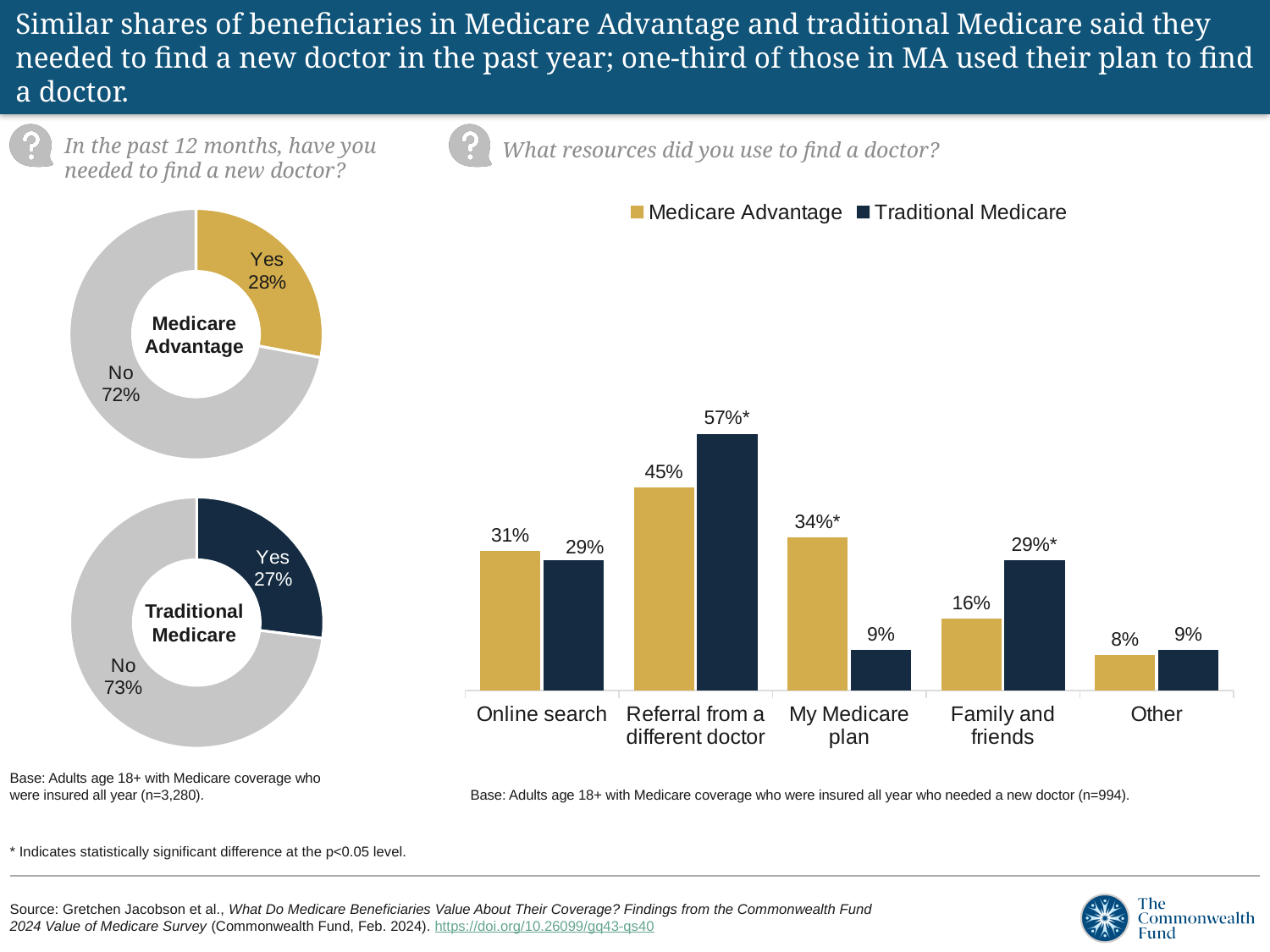
What type of chart is used for 'What resources did you use to find a doctor?' Bar chart In the bar chart 'What resources did you use to find a doctor?', which is larger for 'Family and friends': Medicare Advantage or Traditional Medicare? Traditional Medicare In the Traditional Medicare donut chart, what share of beneficiaries said 'No' to needing a new doctor in the past 12 months? 73% In the bar chart 'What resources did you use to find a doctor?', which resource has the highest value for Traditional Medicare? Referral from a different doctor In the bar chart 'What resources did you use to find a doctor?', how many resource categories are shown? 5 In the bar chart 'What resources did you use to find a doctor?', what percentage of Medicare Advantage beneficiaries used an online search? 31% In the bar chart 'What resources did you use to find a doctor?', which resource has the lowest value for Medicare Advantage? Other In the bar chart 'What resources did you use to find a doctor?', what is the difference between Medicare Advantage and Traditional Medicare for 'My Medicare plan'? 25 percentage points In the Medicare Advantage donut chart, what share of beneficiaries said 'Yes' to needing a new doctor in the past 12 months? 28% In the bar chart 'What resources did you use to find a doctor?', what percentage of Medicare Advantage beneficiaries used family and friends? 16% In the bar chart 'What resources did you use to find a doctor?', what percentage of Traditional Medicare beneficiaries used their Medicare plan? 9% In the bar chart 'What resources did you use to find a doctor?', how many series does the legend list? 2